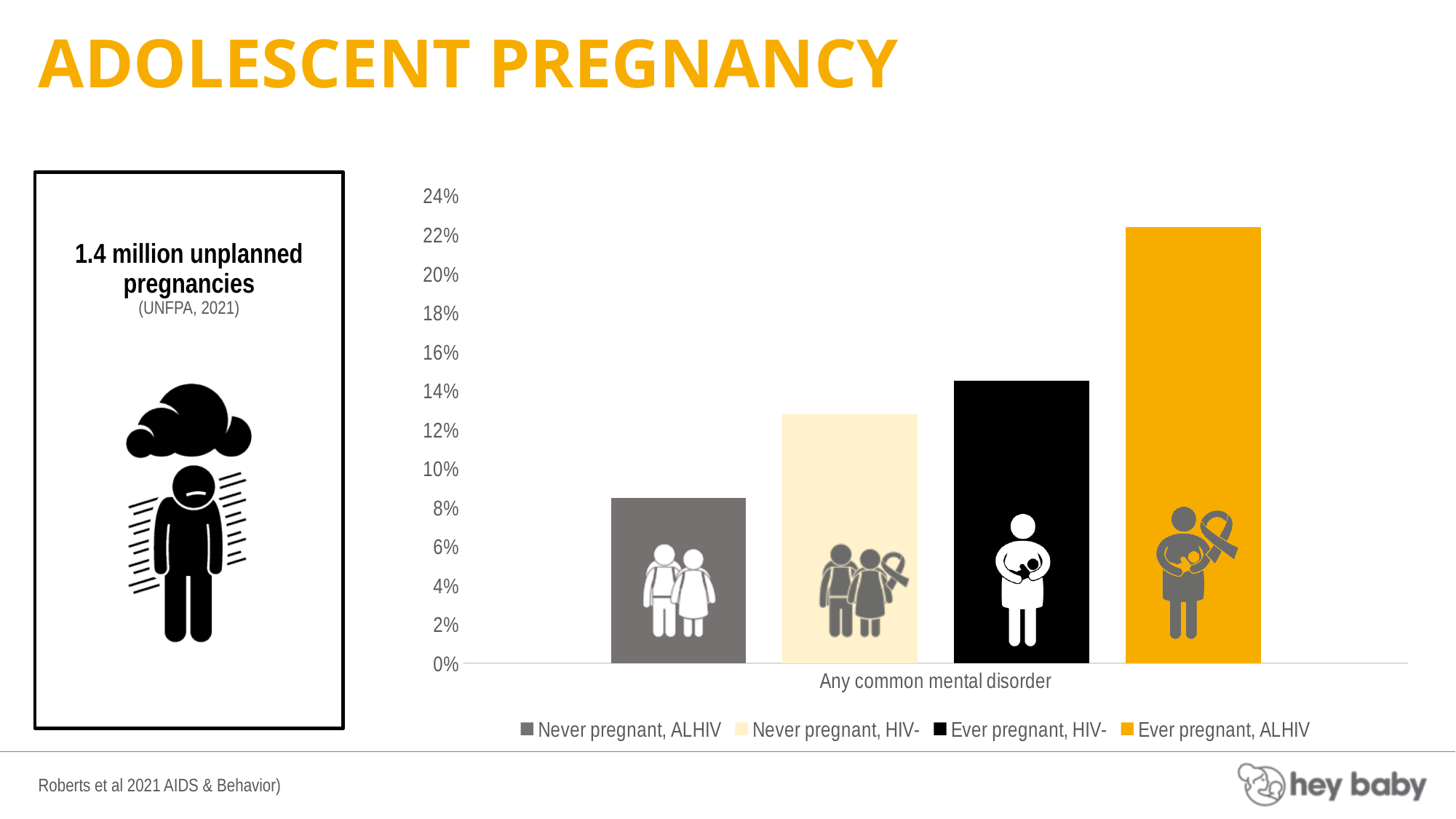
Which series has the lowest value for Any common mental disorder? Never pregnant, ALHIV Is the value for Ever pregnant, ALHIV greater or less than 20%? greater Which series has the highest value for Any common mental disorder? Ever pregnant, ALHIV Is the value for Never pregnant, HIV- greater or less than 12%? greater What is the category label shown on the x axis of the chart? Any common mental disorder Is the value for Never pregnant, ALHIV greater or less than 10%? less How many series does the chart legend list? 4 What kind of chart is shown on the slide? bar chart Which is larger, the value for Ever pregnant, HIV- or the value for Never pregnant, HIV-? Ever pregnant, HIV- How many categories are shown on the x axis of the chart? 1 What colour is the bar for Ever pregnant, ALHIV? orange